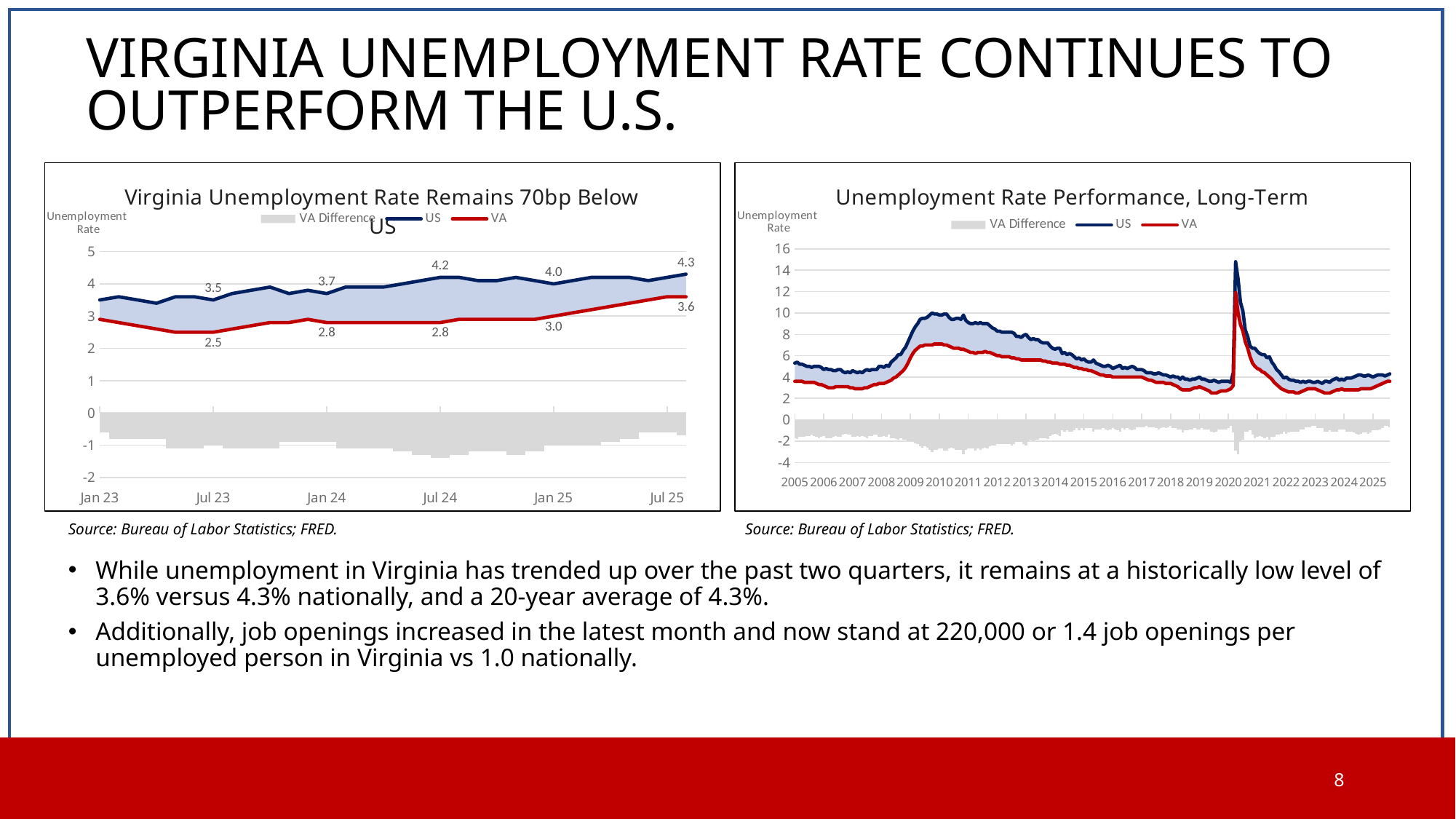
In the left chart (Virginia Unemployment Rate Remains 70bp Below US), what is the US unemployment rate labeled at Jul 25? 4.3 In the left chart, what is the difference between the US and VA labeled values at Jul 25? 0.7 In the left chart, does the VA line rise or fall between Jan 25 and Jul 25? rise In the left chart, what is the US unemployment rate labeled at Jul 24? 4.2 In the left chart, what is the VA unemployment rate labeled at Jul 25? 3.6 In the left chart, which series has the higher labeled value at Jan 24, US or VA? US In the right chart, is the peak VA value around 2020 greater or less than 10? greater How many series does the legend of the left chart list? 3 In the left chart, what is the VA unemployment rate labeled at Jul 23? 2.5 What is the title of the right chart? Unemployment Rate Performance, Long-Term In the left chart, what is the lowest labeled VA value? 2.5 In the right chart (Unemployment Rate Performance, Long-Term), is the peak US value around 2020 greater or less than 12? greater